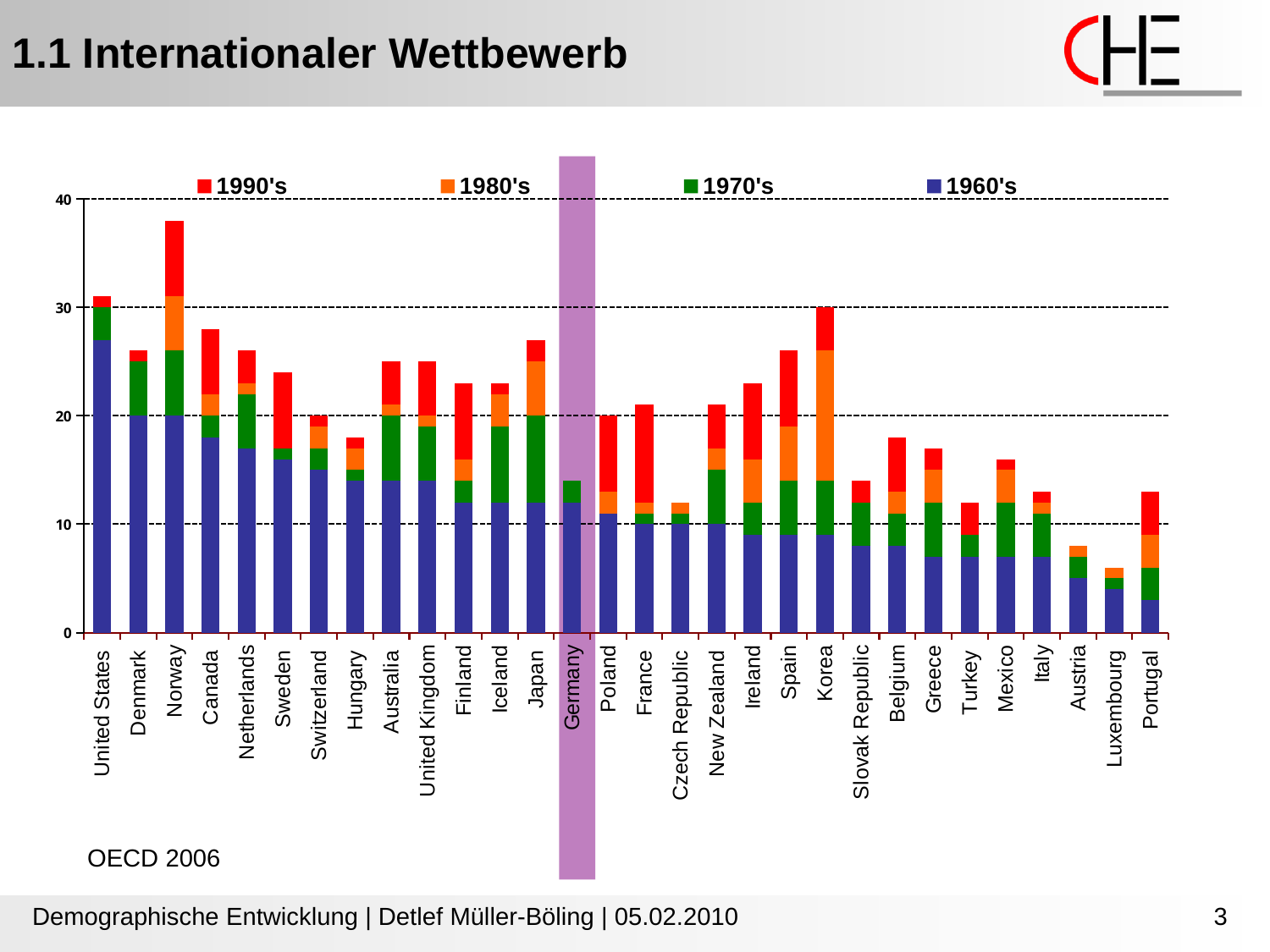
Is the total value for Norway greater or less than 30? greater Is the total value for Luxembourg greater or less than 10? less Which has the larger total bar, Germany or Poland? Poland Which country has the lowest total bar? Luxembourg What kind of chart is shown on the slide? stacked bar chart Is the total value for Austria greater or less than 10? less How many countries are shown on the x axis? 30 How many series does the legend list? 4 Which has the larger total bar, Korea or Spain? Korea Which country is highlighted with a purple band on the chart? Germany Which country has the highest total bar? Norway